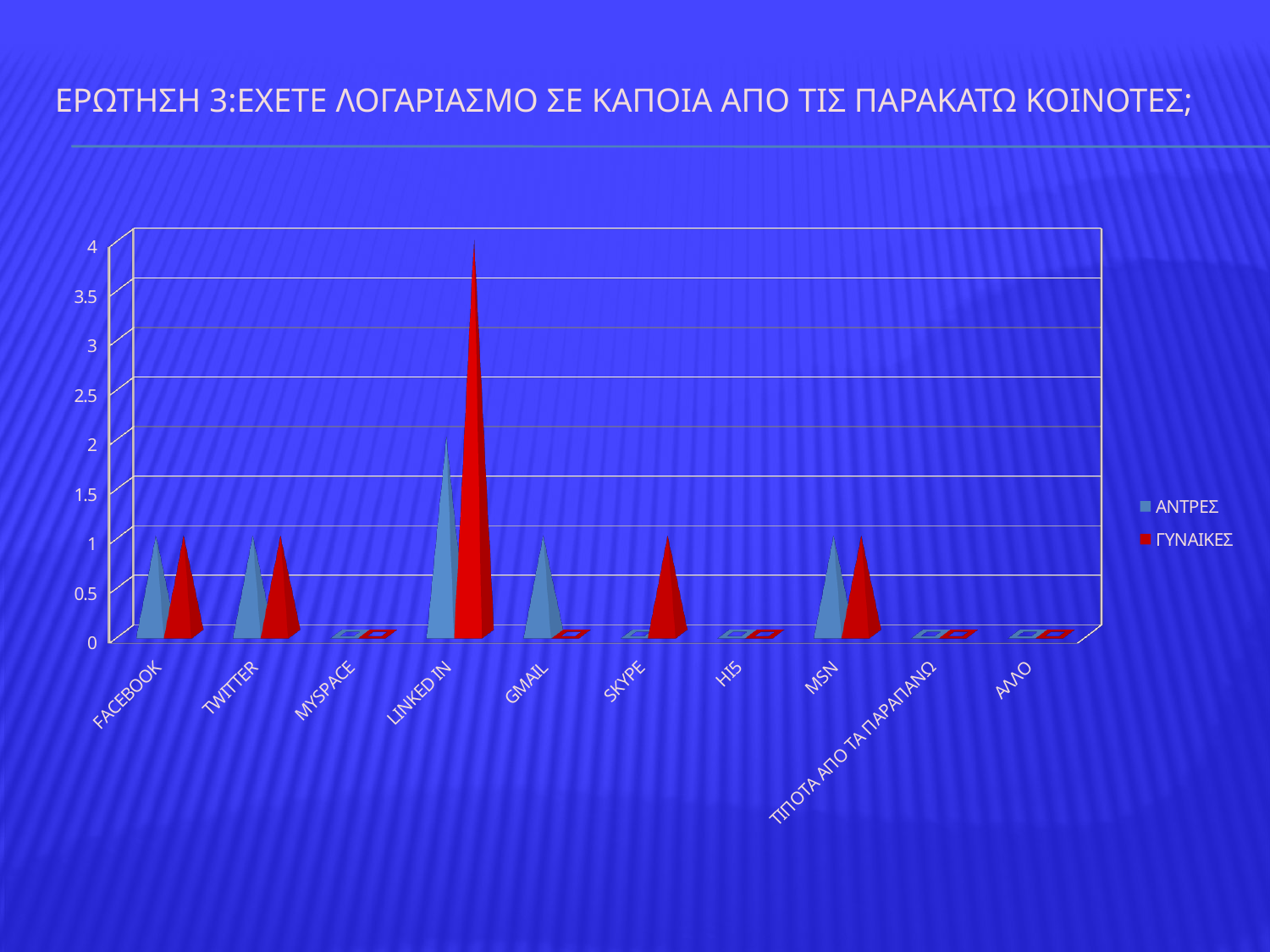
What is the value for ΑΝΤΡΕΣ at LINKED IN? 2 How many categories are shown on the x axis? 10 For LINKED IN, which series has the larger value, ΑΝΤΡΕΣ or ΓΥΝΑΙΚΕΣ? ΓΥΝΑΙΚΕΣ What is the value for ΓΥΝΑΙΚΕΣ at LINKED IN? 4 Which category has the highest value for ΓΥΝΑΙΚΕΣ? LINKED IN What kind of chart is shown on the slide? bar chart Is the value for ΑΝΤΡΕΣ at FACEBOOK greater or less than 1.5? less Which colour represents the ΓΥΝΑΙΚΕΣ series in the legend? red What is the difference between the ΓΥΝΑΙΚΕΣ and ΑΝΤΡΕΣ values at LINKED IN? 2 How many series does the legend list? 2 Is the value for ΓΥΝΑΙΚΕΣ at LINKED IN greater or less than 3? greater Which category has the highest value for ΑΝΤΡΕΣ? LINKED IN